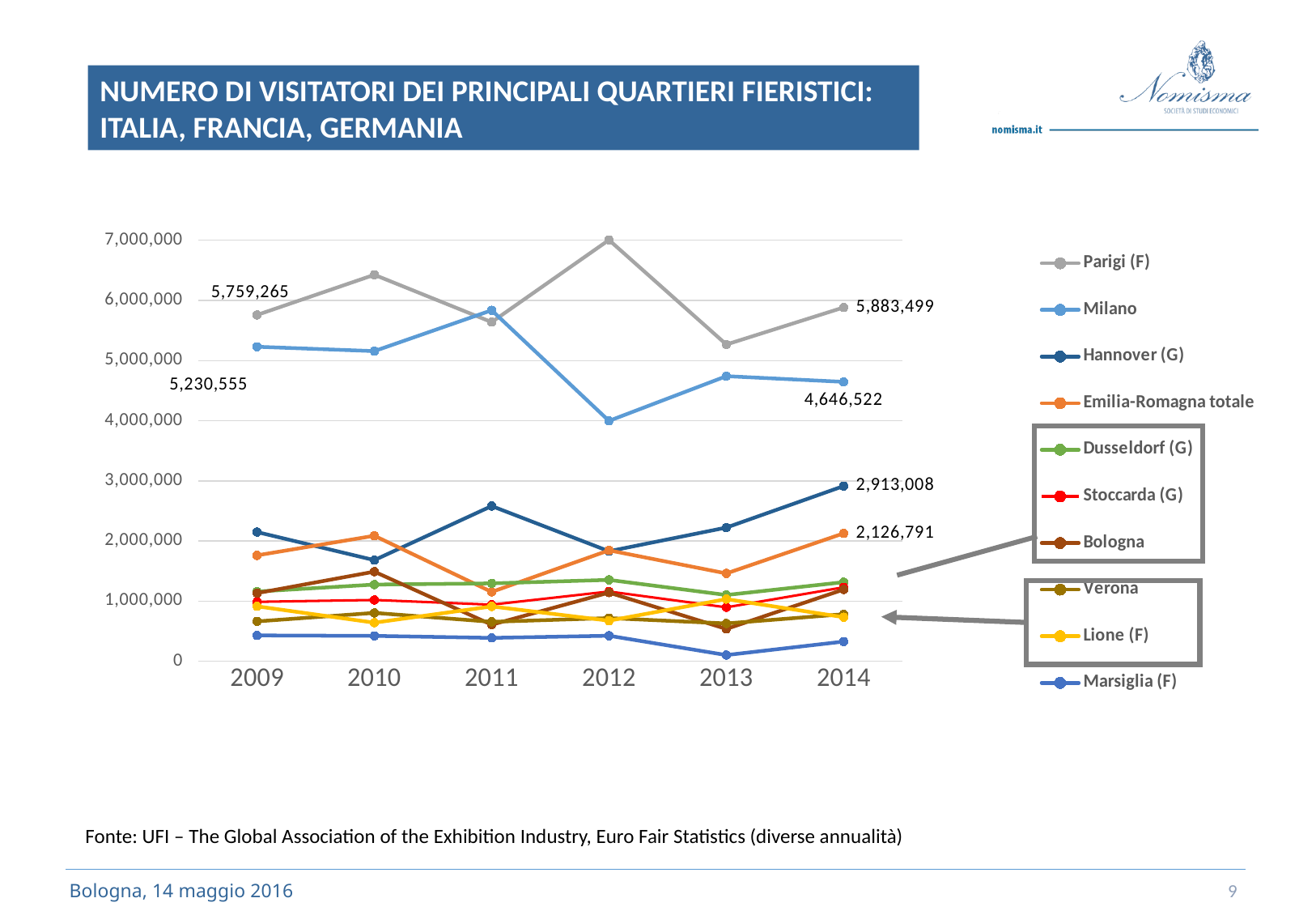
What kind of chart is shown on the slide? line chart What is the number of visitors for Hannover (G) in 2014? 2,913,008 How many series does the legend list? 10 What is the number of visitors for Emilia-Romagna totale in 2014? 2,126,791 What is the number of visitors for Parigi (F) in 2014? 5,883,499 Which series has the lowest value in 2013? Marsiglia (F) By how much did the Milano value fall from 2009 to 2014? 584,033 What is the number of visitors for Milano in 2014? 4,646,522 What is the difference between the 2014 values for Parigi (F) and Milano? 1,236,977 Is the value for Parigi (F) in 2012 greater or less than 6,000,000? greater Which series has the highest value in 2012? Parigi (F) What is the number of visitors for Parigi (F) in 2009? 5,759,265